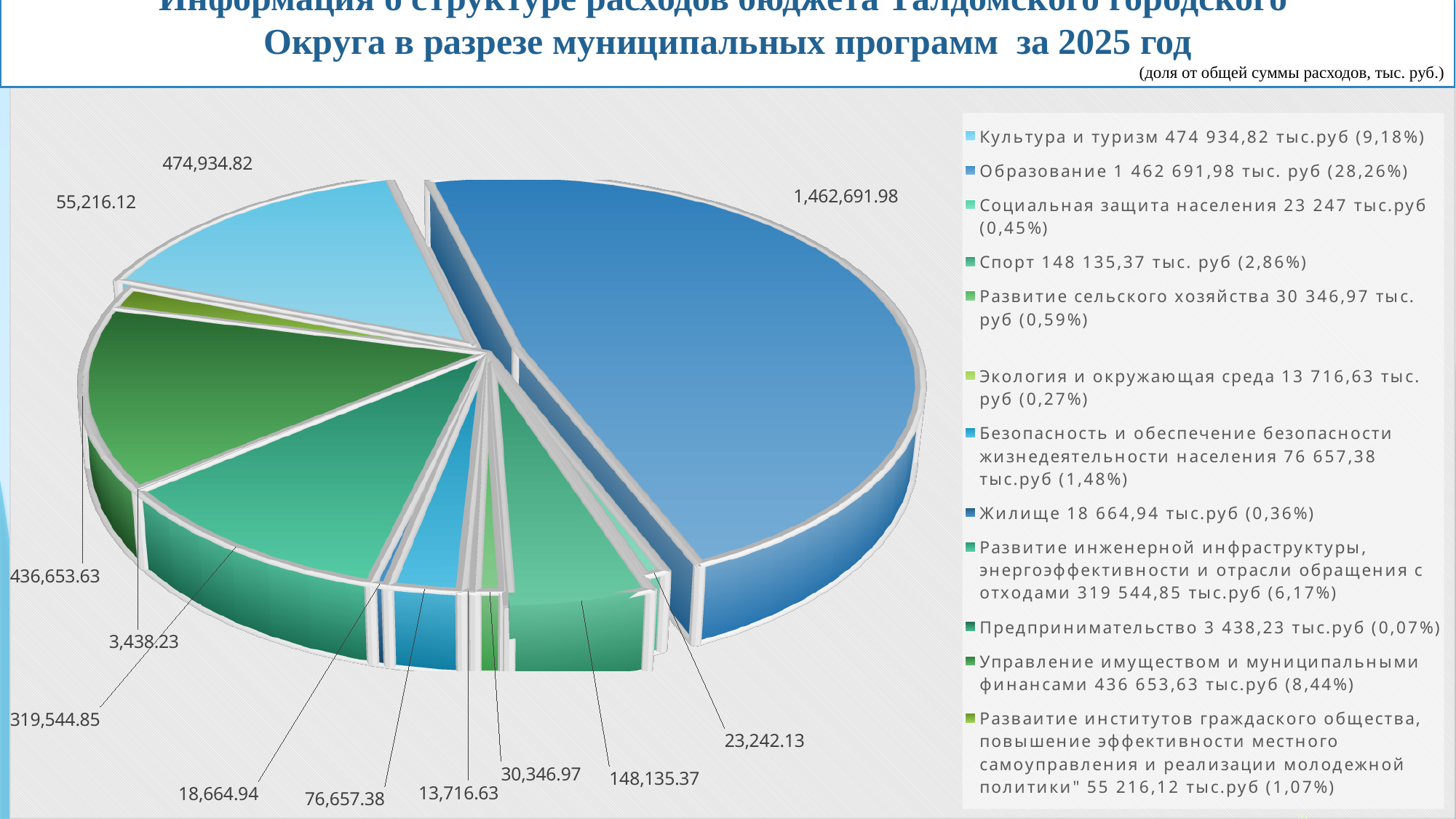
What is the data label value for Спорт? 148,135.37 How many slices (municipal programs) does the pie chart have? 12 According to the legend, what share of total expenditures does Образование represent? 28,26% Which municipal program has the largest expenditure in the pie chart? Образование What is the data label value for Жилище? 18,664.94 What is the difference between the data label values for Спорт (148,135.37) and Безопасность и обеспечение безопасности жизнедеятельности населения (76,657.38)? 71,477.99 Which municipal program has the smallest expenditure in the pie chart? Предпринимательство What kind of chart is shown on the slide? Pie chart What is the data label value for Культура и туризм? 474,934.82 Which is larger: the expenditure for Культура и туризм or for Управление имуществом и муниципальными финансами? Культура и туризм What is the data label value for Образование? 1,462,691.98 According to the legend, what share of total expenditures does Управление имуществом и муниципальными финансами represent? 8,44%